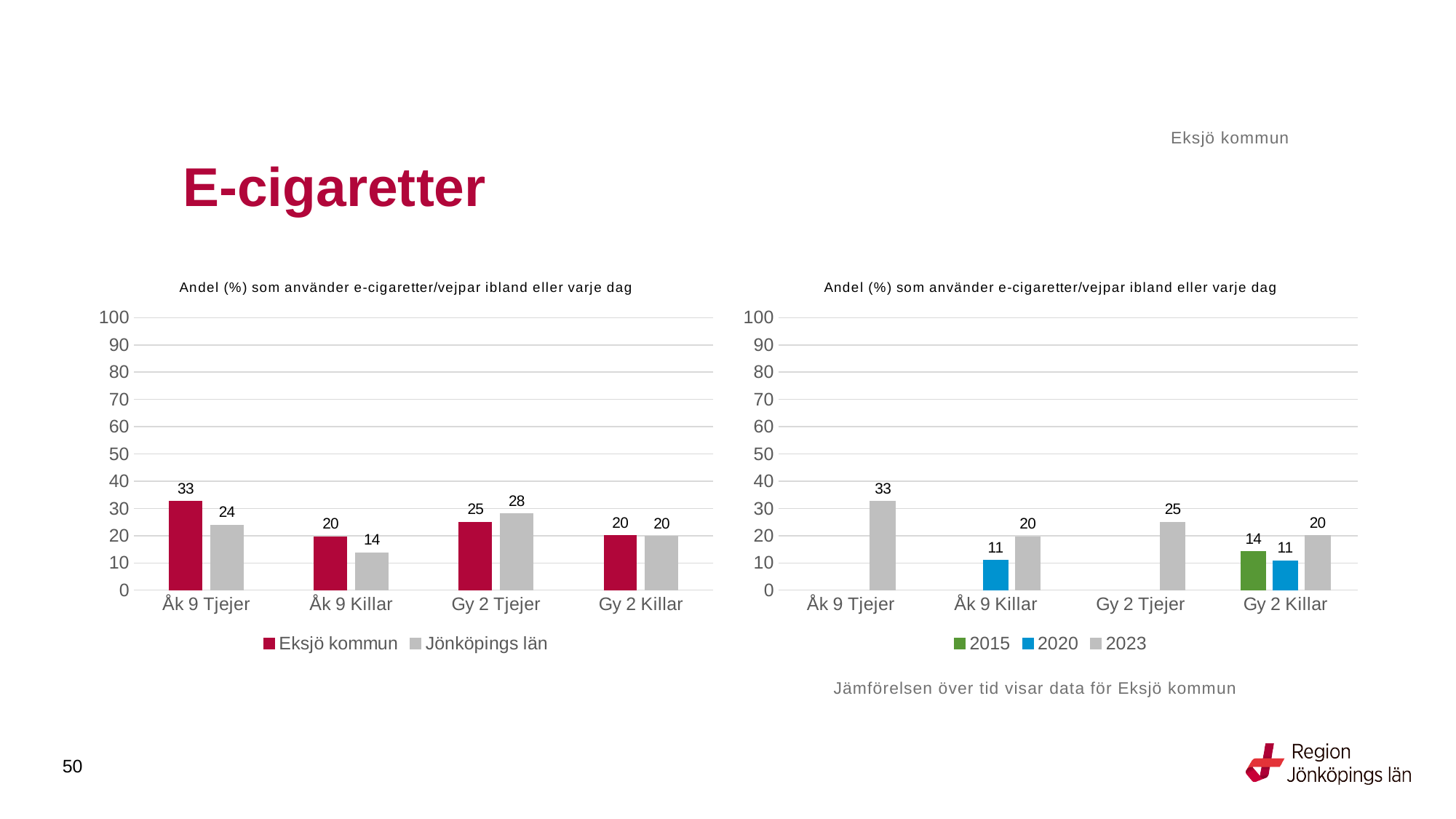
In the right chart, what is the value for 2023 for Gy 2 Tjejer? 25 How many series does the legend of the left chart list? 2 In the left chart, what is the value for Eksjö kommun for Åk 9 Tjejer? 33 In the left chart, what is the difference between Eksjö kommun and Jönköpings län for Åk 9 Tjejer? 9 In the right chart, what is the value for 2020 for Gy 2 Killar? 11 In the left chart, which category has the highest value for Jönköpings län? Gy 2 Tjejer In the right chart, which category has the highest value for 2023? Åk 9 Tjejer How many series does the legend of the right chart list? 3 What kind of chart is the right chart? Bar chart In the left chart, which is larger for Gy 2 Tjejer: Eksjö kommun or Jönköpings län? Jönköpings län In the left chart, what is the value for Jönköpings län for Åk 9 Killar? 14 In the right chart, what is the difference between 2023 and 2020 for Åk 9 Killar? 9